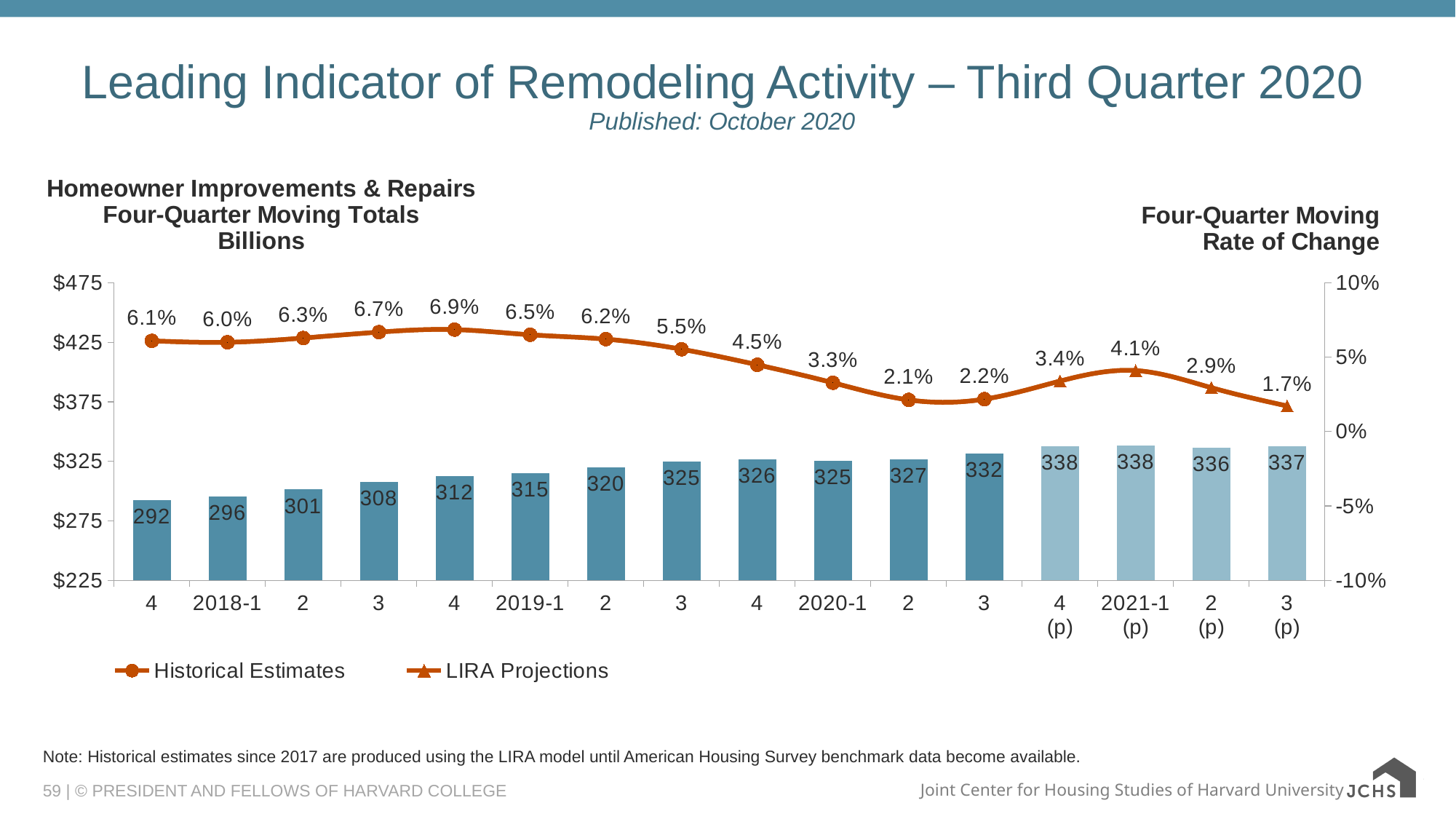
What is the four-quarter moving total (billions) for 2020-1? 325 Which quarter has the lowest four-quarter moving rate of change? 2021-3 (p), at 1.7% What is the four-quarter moving rate of change for 2019-1? 6.5% Which has the larger four-quarter moving total, 2019-3 or 2019-4? 2019-4 What is the projected four-quarter moving total for 2021-1 (p)? 338 How many series does the legend list? 2 What is the difference in the rate of change between 2019-4 (4.5%) and 2020-1 (3.3%)? 1.2 percentage points How many quarters (bars) are plotted on the chart? 16 What kind of chart is shown on the slide? Combination bar and line chart What is the highest four-quarter moving rate of change shown on the line? 6.9% By how much does the four-quarter moving total for 2020-3 exceed that for 2020-2? 5 Does the four-quarter moving rate of change rise or fall from 2018-4 to 2020-2? Fall